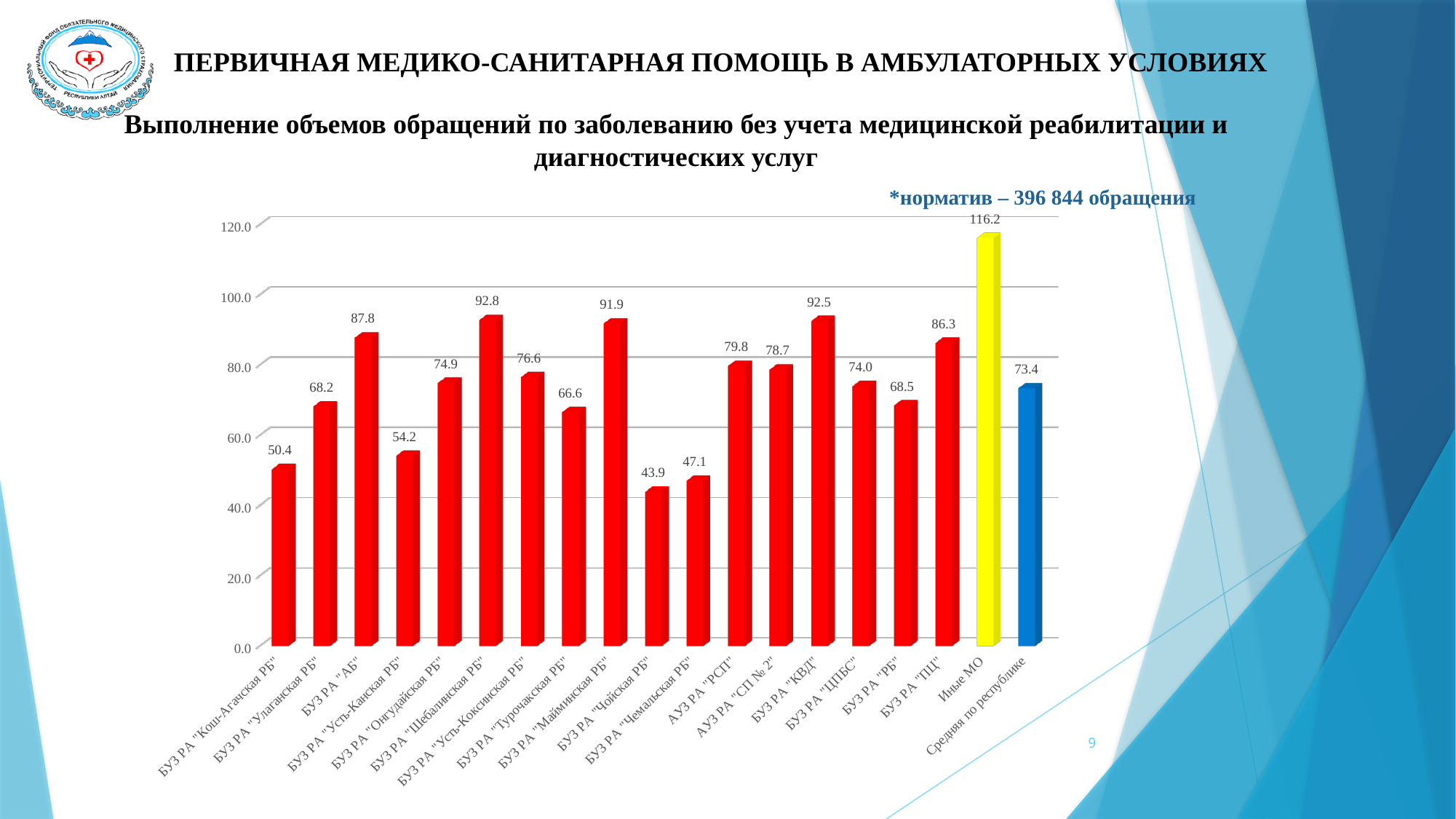
What is the difference between the values for БУЗ РА "КВД" and БУЗ РА "ЦПБС"? 18.5 What is the value for БУЗ РА "Чойская РБ"? 43.9 Which is larger, the value for БУЗ РА "АБ" or the value for БУЗ РА "ПЦ"? БУЗ РА "АБ" What type of chart is shown on the slide? bar chart What is the value for БУЗ РА "Шебалинская РБ"? 92.8 Which category has the highest value in the chart? Иные МО Which category has the lowest value in the chart? БУЗ РА "Чойская РБ" What colour is the bar for Средняя по республике? blue What is the difference between the values for Иные МО and Средняя по республике? 42.8 How many categories (bars) are plotted in the chart? 19 What is the value for Средняя по республике? 73.4 Is the value for БУЗ РА "Кош-Агачская РБ" greater or less than 60.0? less